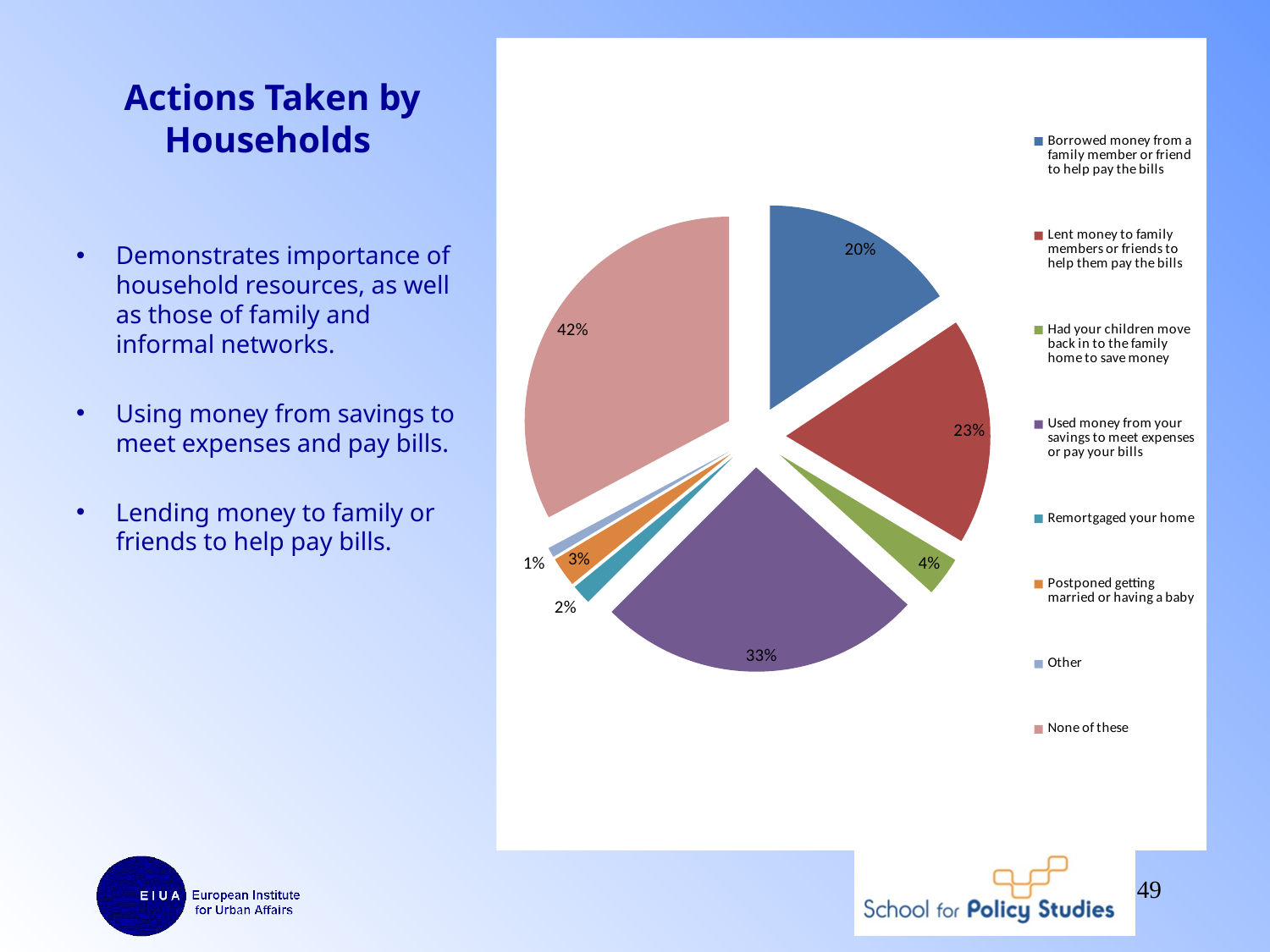
Which category has the smallest slice of the pie? Other What percentage of households lent money to family members or friends to help them pay the bills? 23% What colour is the slice for 'Used money from your savings to meet expenses or pay your bills'? purple What kind of chart is shown on the slide? pie chart What percentage of households answered 'None of these'? 42% Which category has the largest slice of the pie? None of these What is the difference between the percentage for 'Lent money to family members or friends' and 'Borrowed money from a family member or friend'? 3% What percentage of households had their children move back in to the family home to save money? 4% What percentage of households used money from their savings to meet expenses or pay bills? 33% Which is larger: the percentage that remortgaged their home or the percentage that postponed getting married or having a baby? Postponed getting married or having a baby How many categories does the legend list? 8 What percentage of households borrowed money from a family member or friend to help pay the bills? 20%